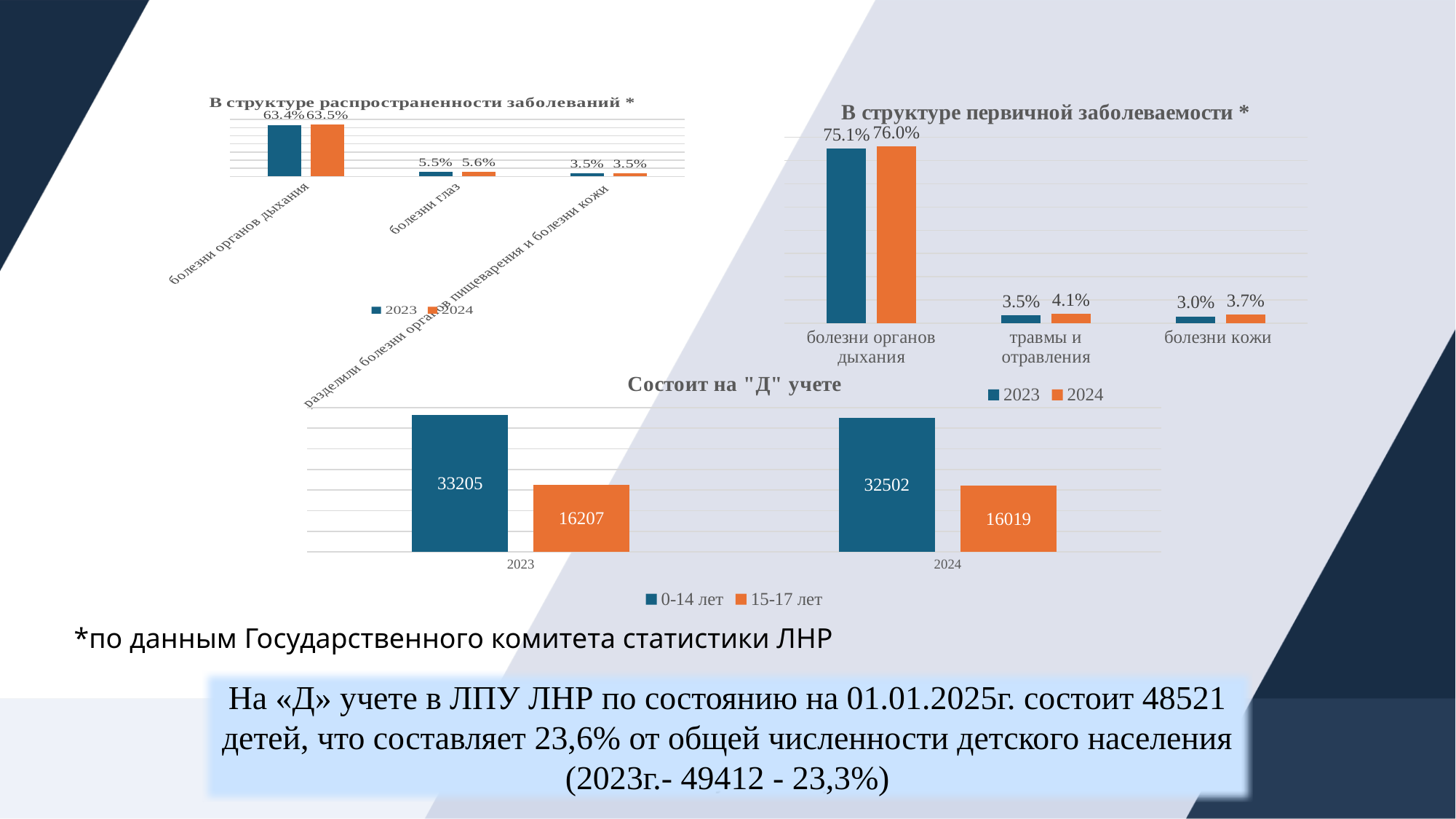
In the chart "Состоит на "Д" учете", does the value for 0-14 лет rise or fall from 2023 to 2024? fall In the chart "В структуре первичной заболеваемости *", what is the difference between the 2024 and 2023 values for болезни кожи? 0.7% In the chart "В структуре распространенности заболеваний *", what is the 2023 value for болезни органов дыхания? 63.4% In the chart "Состоит на "Д" учете", what is the total of the two age groups for 2024? 48521 In the chart "В структуре первичной заболеваемости *", which category has the highest values? болезни органов дыхания In the chart "В структуре первичной заболеваемости *", how many series does the legend list? 2 In the chart "Состоит на "Д" учете", what is the value for 0-14 лет in 2023? 33205 What kind of chart is "Состоит на "Д" учете"? bar chart In the chart "В структуре первичной заболеваемости *", what is the 2023 value for травмы и отравления? 3.5% In the chart "Состоит на "Д" учете", what is the value for 15-17 лет in 2024? 16019 In the chart "В структуре распространенности заболеваний *", what is the 2024 value for болезни глаз? 5.6% In the chart "В структуре первичной заболеваемости *", what is the 2024 value for болезни органов дыхания? 76.0%